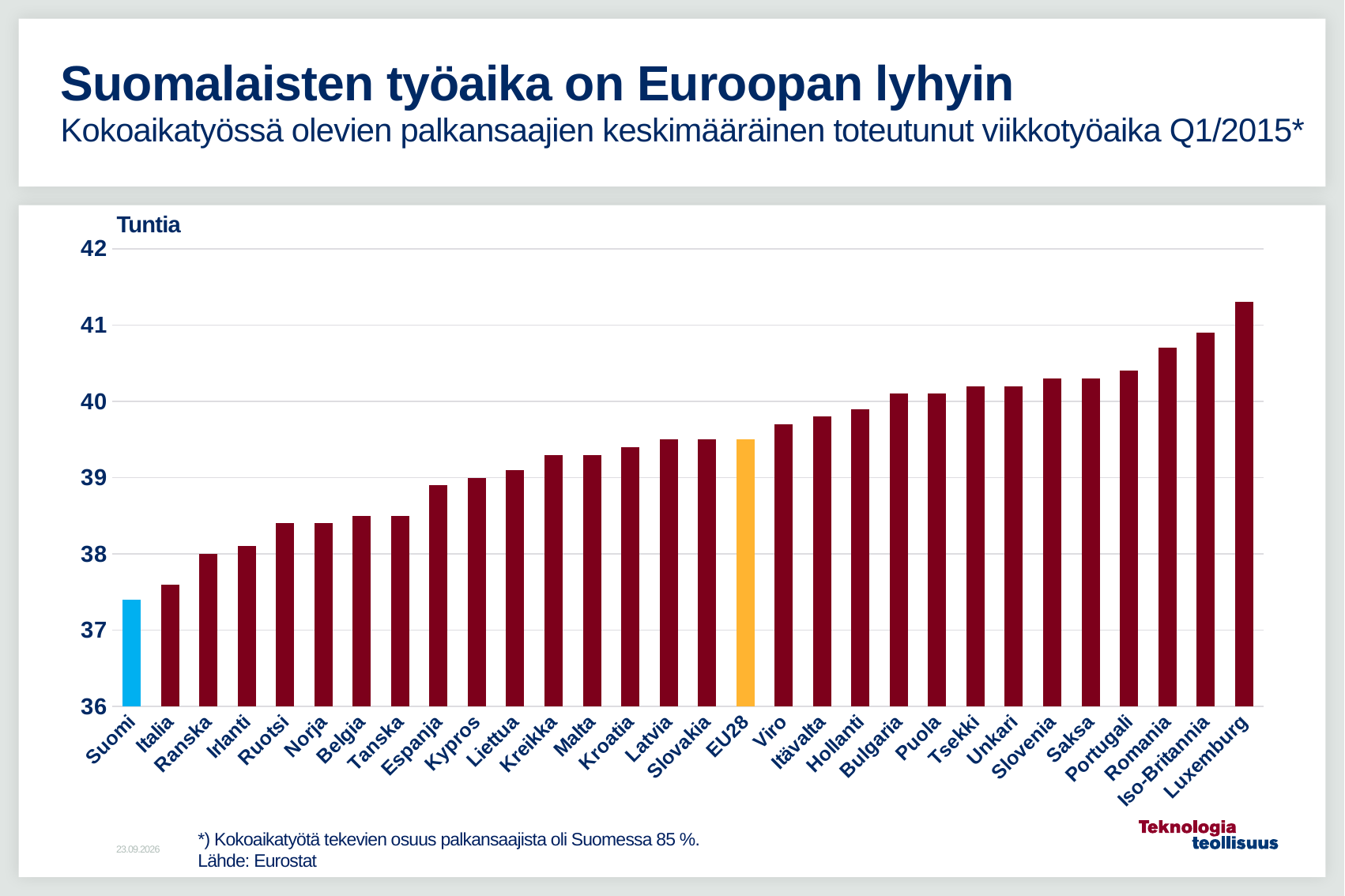
How many bars (categories) are plotted in the chart? 30 What kind of chart is shown on the slide? Bar chart Which country has the lowest average weekly working time in the chart? Suomi Which has a larger value, Romania or Viro? Romania Which country has the highest average weekly working time in the chart? Luxemburg Do the values rise or fall moving from left to right along the x axis? Rise What colour is the bar for Suomi? Blue What unit is shown on the vertical axis label? Tuntia Is the value for Espanja greater or less than 39? less Is the value for Suomi greater or less than 38? less Is the value for Saksa greater or less than 40? greater